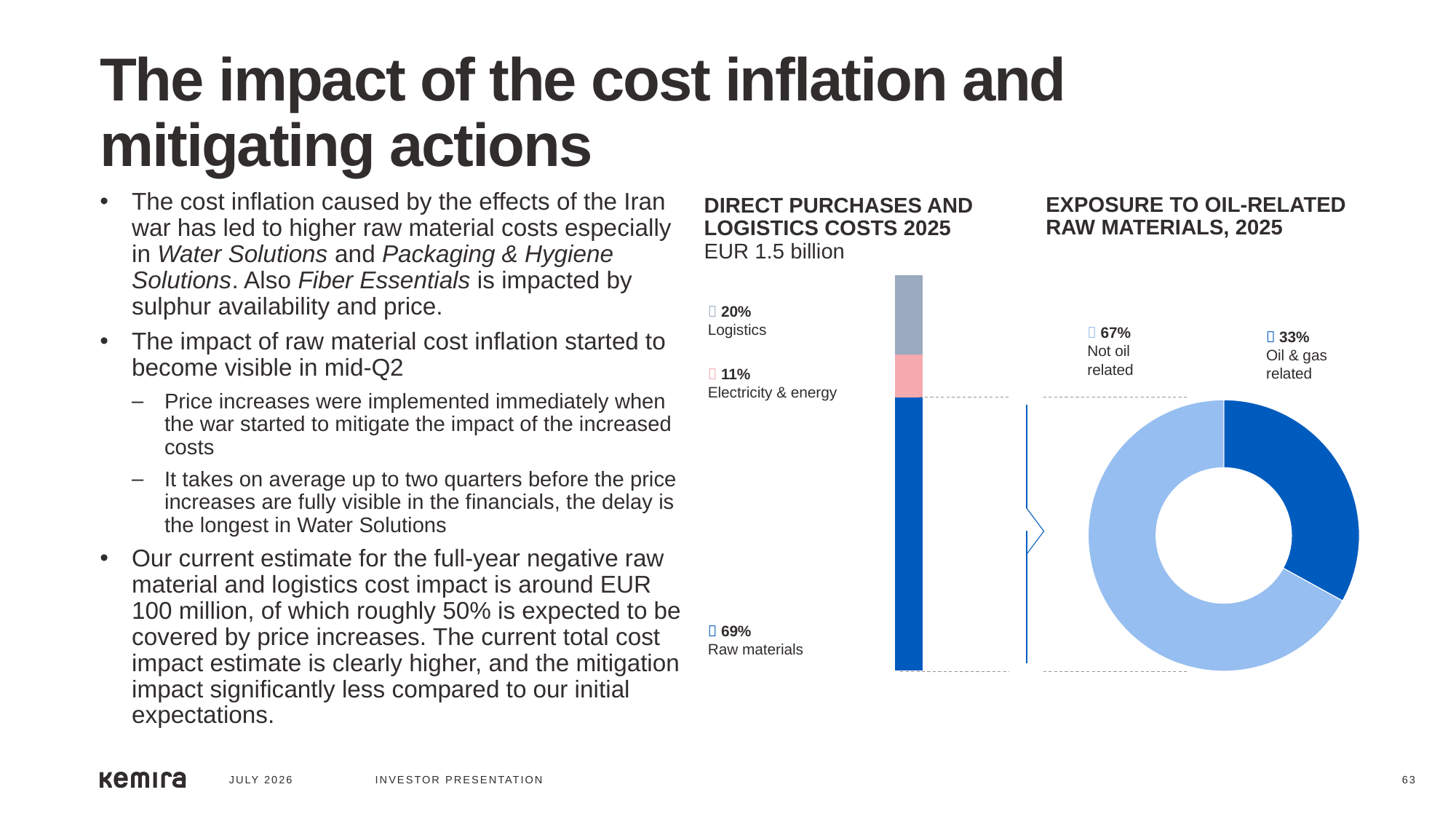
What total value is stated for the 'Direct purchases and logistics costs 2025' chart? EUR 1.5 billion What kind of chart is the 'Exposure to oil-related raw materials, 2025' chart? Donut (pie) chart In the 'Direct purchases and logistics costs 2025' chart, what share is Logistics? 20% In the 'Exposure to oil-related raw materials, 2025' chart, what share is Not oil related? 67% In the 'Exposure to oil-related raw materials, 2025' chart, which is larger: Not oil related or Oil & gas related? Not oil related In the 'Direct purchases and logistics costs 2025' chart, how many categories make up the stacked bar? 3 In the 'Exposure to oil-related raw materials, 2025' chart, what share is Oil & gas related? 33% In the 'Direct purchases and logistics costs 2025' chart, what is the difference between the Logistics share and the Electricity & energy share? 9 percentage points In the 'Direct purchases and logistics costs 2025' chart, which category has the largest share? Raw materials In the 'Direct purchases and logistics costs 2025' chart, what share is Electricity & energy? 11% In the 'Direct purchases and logistics costs 2025' chart, which category has the smallest share? Electricity & energy In the 'Direct purchases and logistics costs 2025' chart, what share is Raw materials? 69%